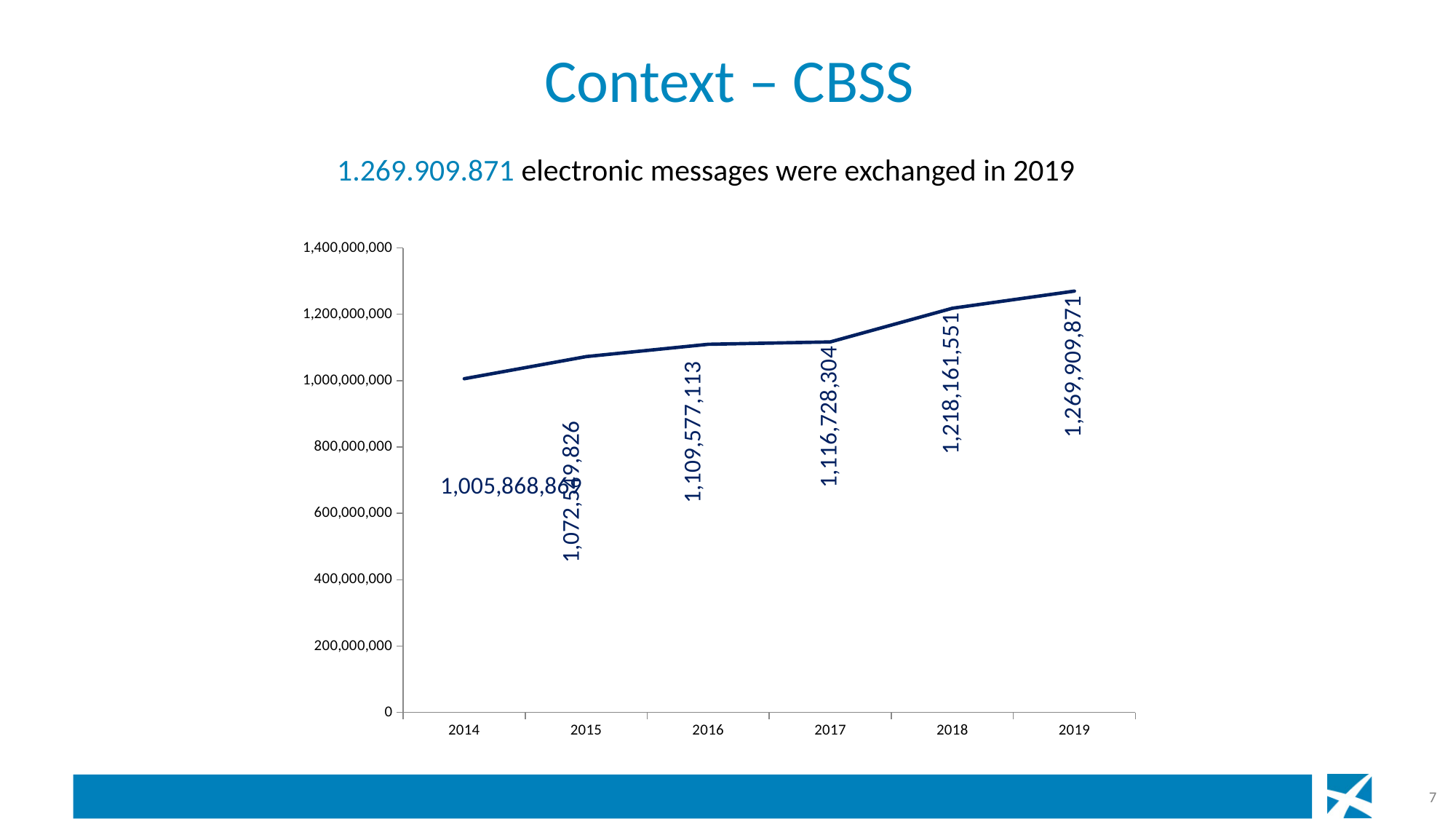
What is the difference between the values for 2019 and 2018? 51,748,320 What is the value plotted for 2017? 1,116,728,304 What type of chart is shown on the slide? Line chart Which year has the highest value on the chart? 2019 How many years are plotted on the x axis of the chart? 6 Do the values rise or fall from 2014 to 2019? Rise What is the value plotted for 2018? 1,218,161,551 What is the value plotted for 2019? 1,269,909,871 What is the value plotted for 2016? 1,109,577,113 Which year has the larger value, 2016 or 2017? 2017 What is the difference between the values for 2018 and 2017? 101,433,247 Which year has the lowest value on the chart? 2014